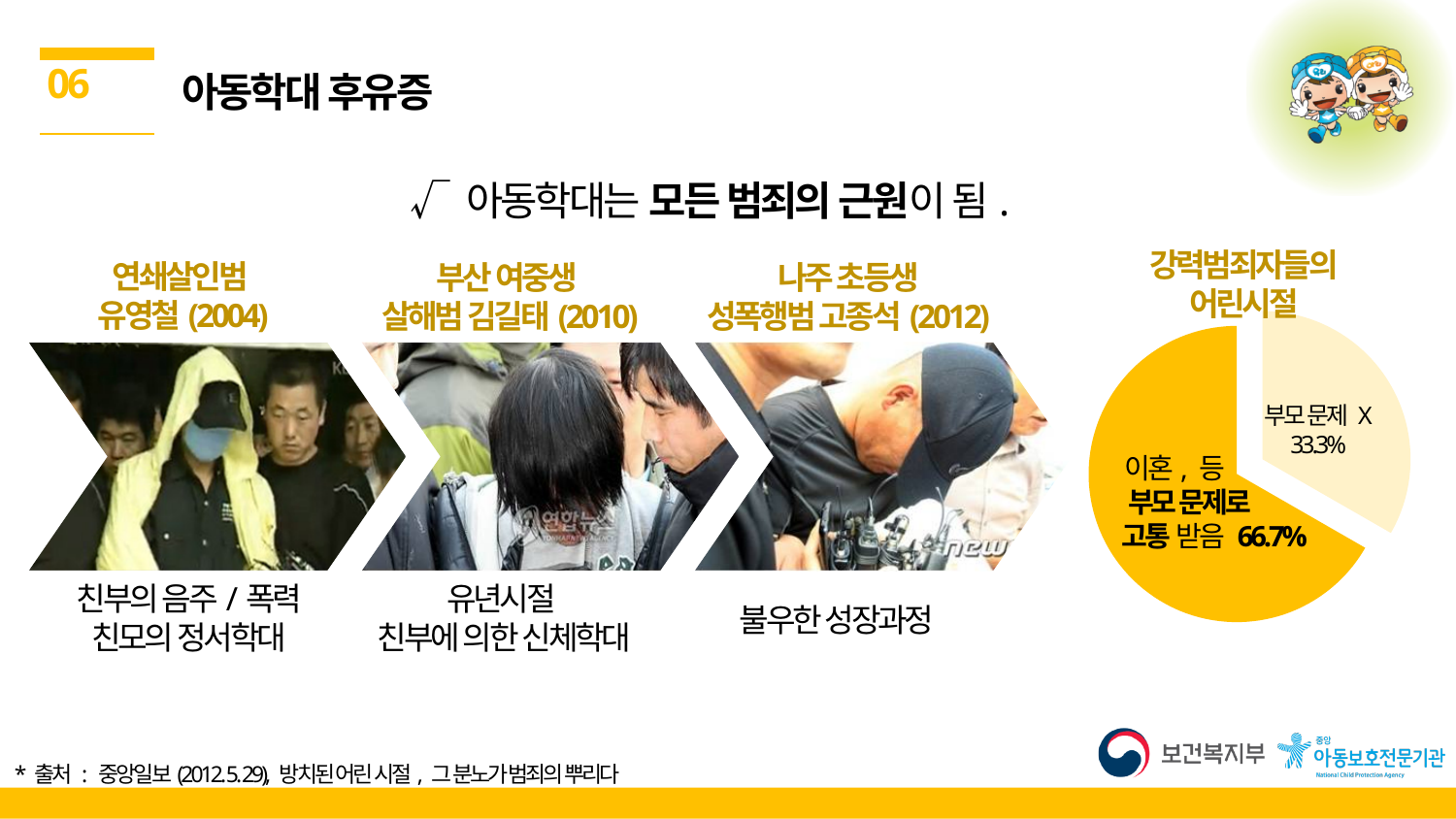
Which slice of the pie chart is the largest? 이혼, 등 부모 문제로 고통 받음 What is the title of the pie chart? 강력범죄자들의 어린시절 Which slice of the pie chart is the smallest? 부모 문제 X What colour is the larger slice of the pie chart? yellow Is the share for '부모 문제로 고통 받음' greater or less than 50%? greater Which is larger: the share for '부모 문제 X' or the share for '부모 문제로 고통 받음'? 부모 문제로 고통 받음 What share of the pie is labelled '이혼, 등 부모 문제로 고통 받음'? 66.7% Is the share for '부모 문제 X' greater or less than 50%? less What share of the pie is labelled '부모 문제 X'? 33.3% What is the difference in percentage points between the '부모 문제로 고통 받음' slice and the '부모 문제 X' slice? 33.4% What kind of chart is shown on the slide? pie chart How many slices does the pie chart have? 2